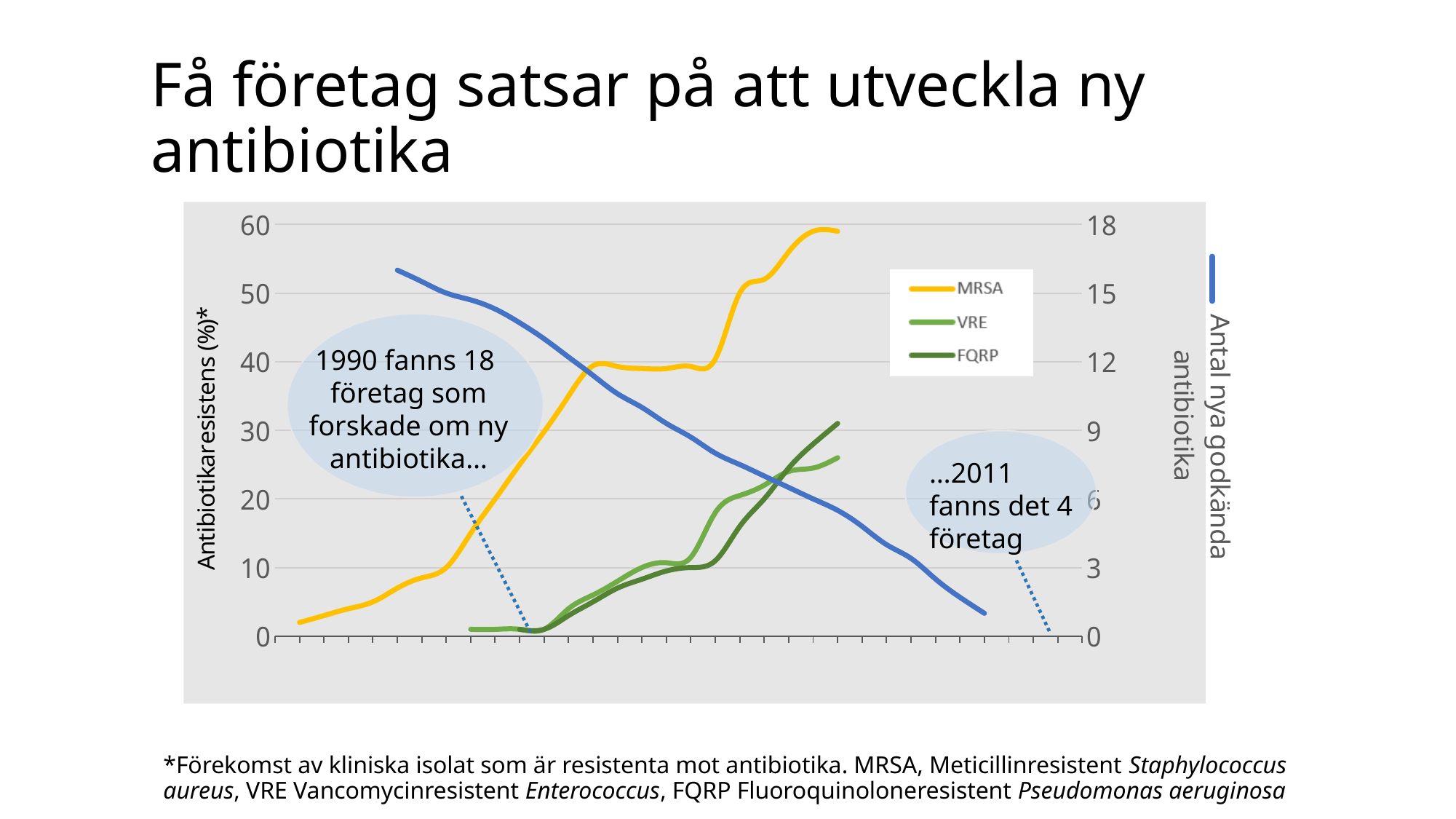
Is the final value of the MRSA line greater or less than 50? greater At the right end of the chart, which is higher, the MRSA line or the VRE line? MRSA Which series are listed in the chart's legend? MRSA, VRE, FQRP Does the MRSA line rise or fall along the x axis? rises How many series does the chart's legend list? 3 What is the label of the right-hand vertical axis? Antal nya godkända antibiotika Does the blue line for the number of new approved antibiotics rise or fall along the x axis? falls Is the final value of the VRE line greater or less than 20? greater What kind of chart is shown on the slide? line chart Which of the three resistance series reaches the highest value on the chart? MRSA According to the annotation, how many companies were researching new antibiotics in 1990? 18 According to the annotation, how many companies were there in 2011? 4